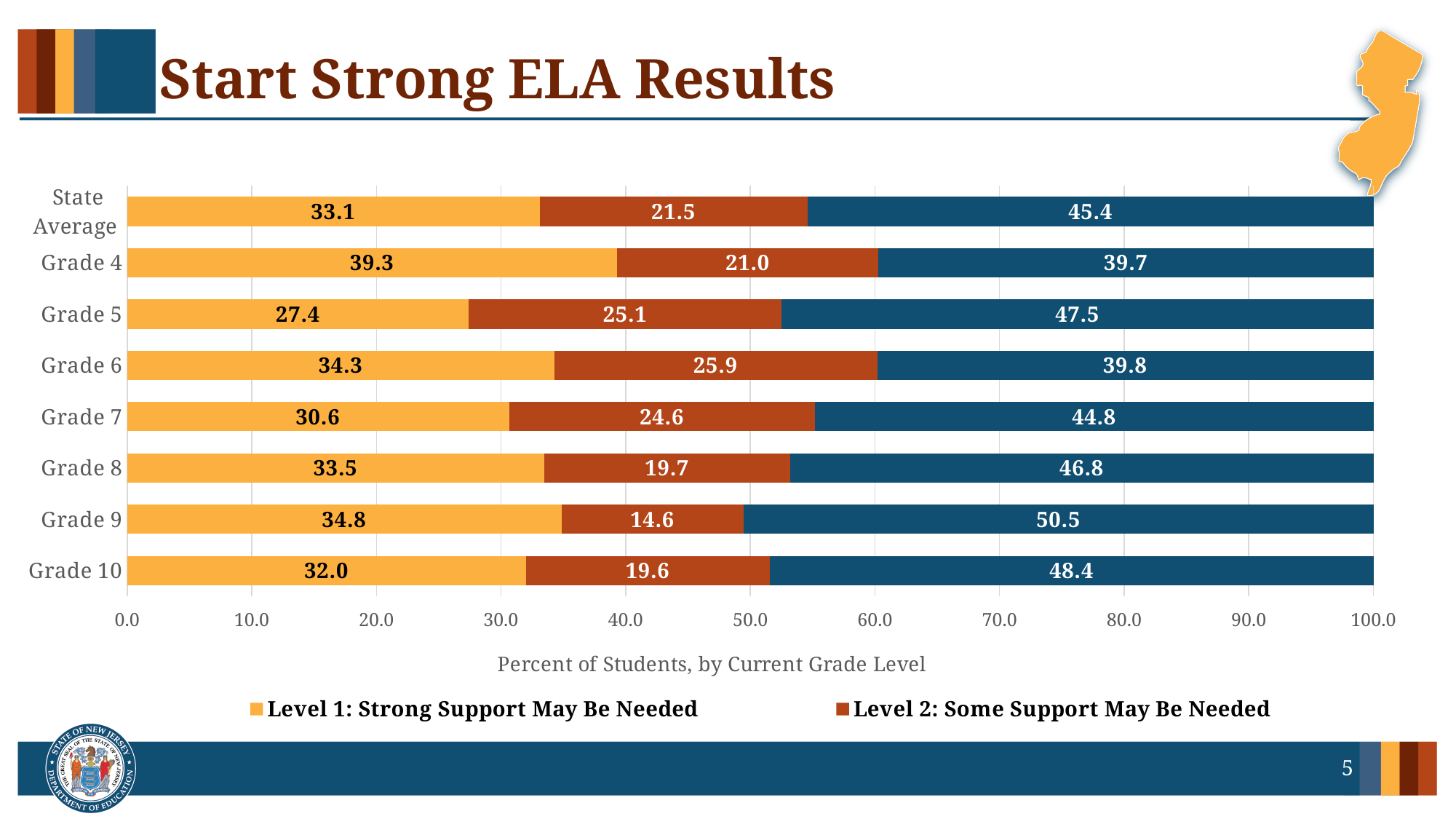
What is the label of the horizontal axis? Percent of Students, by Current Grade Level How many series does the legend list? 2 How many categories are shown on the vertical axis? 8 What is the total of the Level 1 and Level 2 values for Grade 4? 60.3 What is the Level 2 value for Grade 9? 14.6 Which grade has the highest Level 1 value? Grade 4 What kind of chart is shown on the slide? Stacked bar chart What is the Level 1 value for Grade 5? 27.4 What is the Level 1 value for the State Average? 33.1 What is the difference between the Level 2 values for Grade 6 and Grade 8? 6.2 Which grade has the lowest Level 2 value? Grade 9 Which is larger, the Level 1 value for Grade 7 or for Grade 10? Grade 10